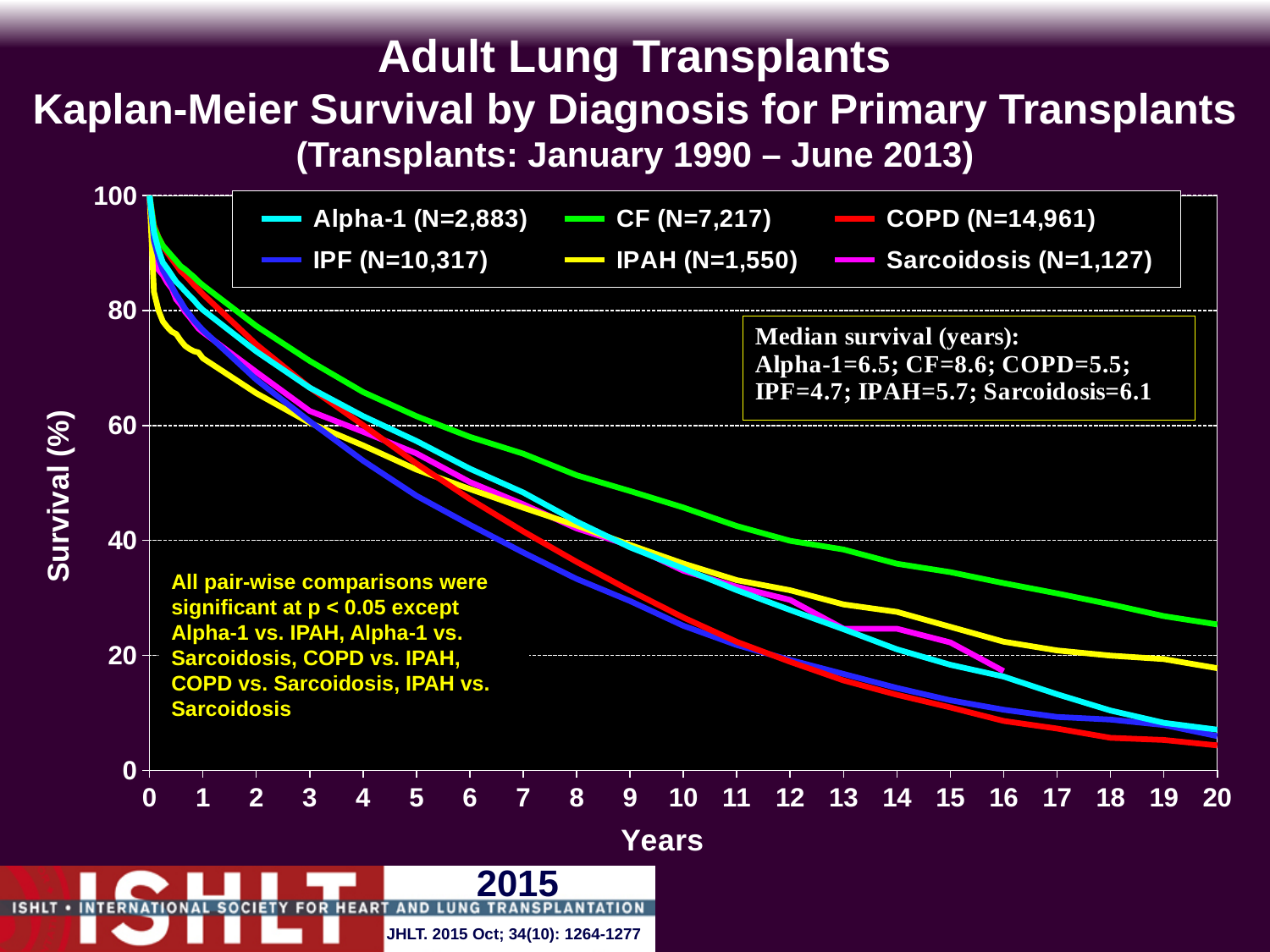
What is the N for COPD shown in the legend? 14,961 What is the difference in median survival (years) between CF and IPF? 3.9 Which diagnosis has the highest median survival? CF Which has the larger median survival, Alpha-1 or Sarcoidosis? Alpha-1 Do the survival curves rise or fall as years increase? fall How many diagnosis groups does the legend list? 6 Which diagnosis has the lowest median survival? IPF What kind of chart is shown on the slide? line chart What is the median survival in years for CF according to the text box on the chart? 8.6 Is the survival for COPD at 15 years greater or less than 20? less Is the survival for CF at 10 years greater or less than 40? greater What is the median survival in years for IPF according to the text box on the chart? 4.7